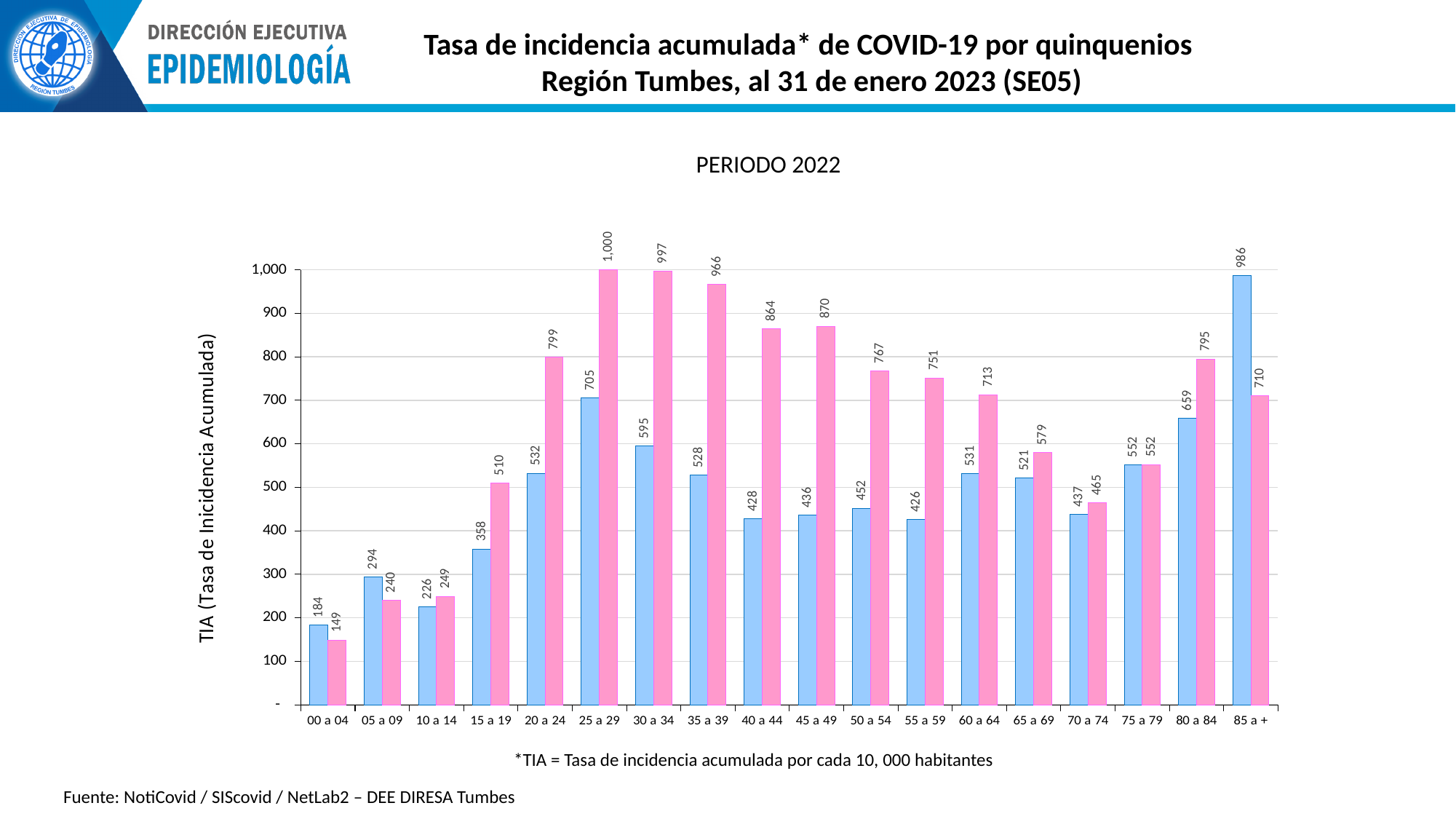
What is the value of the blue bar for the 00 a 04 age group? 184 What is the value of the pink bar for the 25 a 29 age group? 1,000 What is the title shown above the chart? PERIODO 2022 What is the value of the blue bar for the 85 a + age group? 986 What type of chart is shown on the slide? bar chart For the 05 a 09 age group, which bar is larger, the blue or the pink? blue Which age group has the highest blue bar? 85 a + What is the difference between the pink and blue bars for the 30 a 34 age group? 402 How many age-group categories are shown on the x axis? 18 Which age group has the lowest pink bar? 00 a 04 What is the label of the y axis? TIA (Tasa de Incidencia Acumulada) Which age group has the highest pink bar? 25 a 29